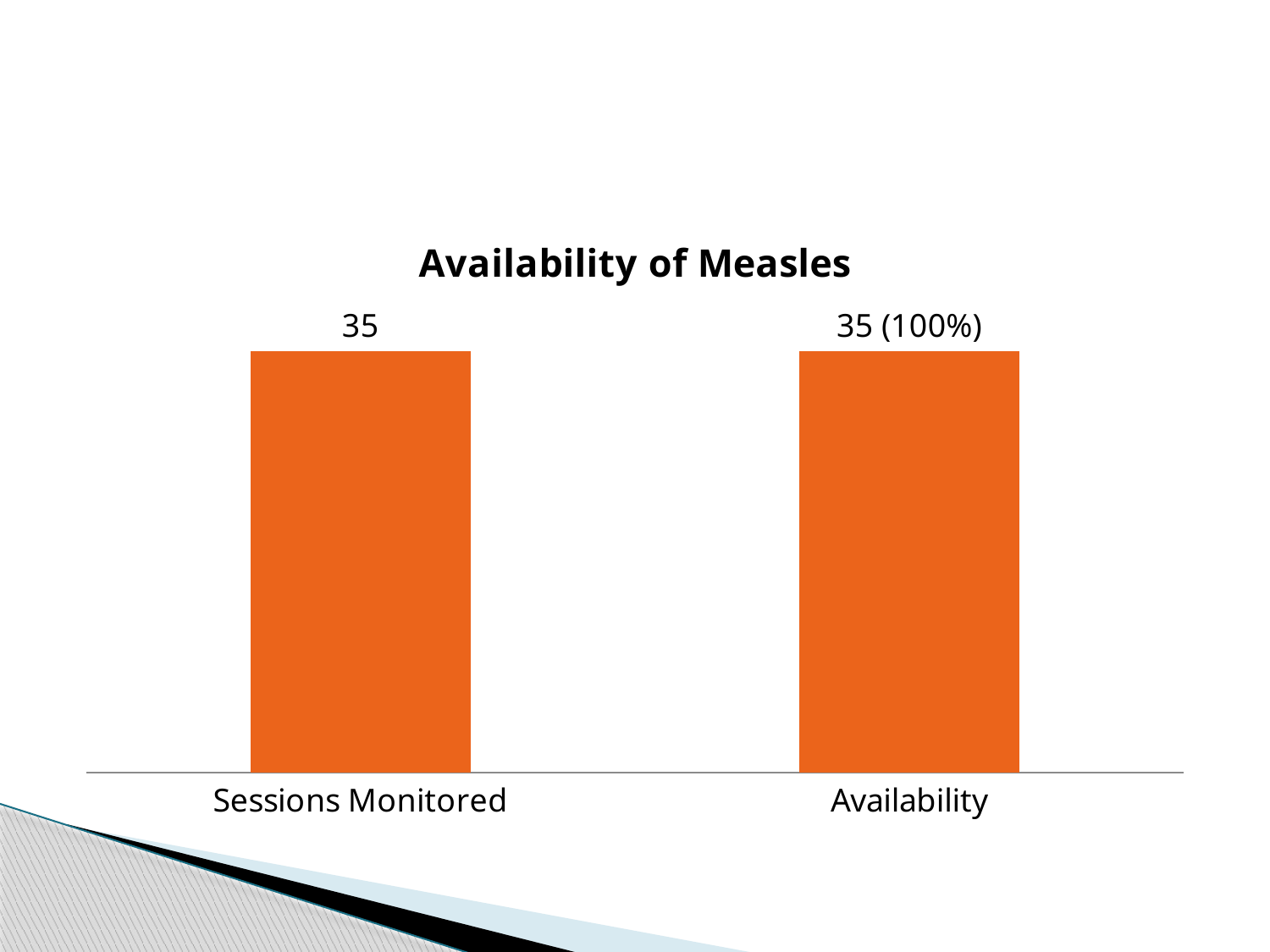
What is the data label shown on the Availability bar? 35 (100%) What kind of chart is shown on the slide? bar chart What is the label of the second category on the x axis? Availability What is the label of the first category on the x axis? Sessions Monitored What colour are the bars in the chart? orange What is the value shown for Sessions Monitored? 35 What is the difference between the value for Sessions Monitored and the value for Availability? 0 What is the title of the chart? Availability of Measles What percentage is shown in the data label for Availability? 100% How many categories are shown on the x axis of the chart? 2